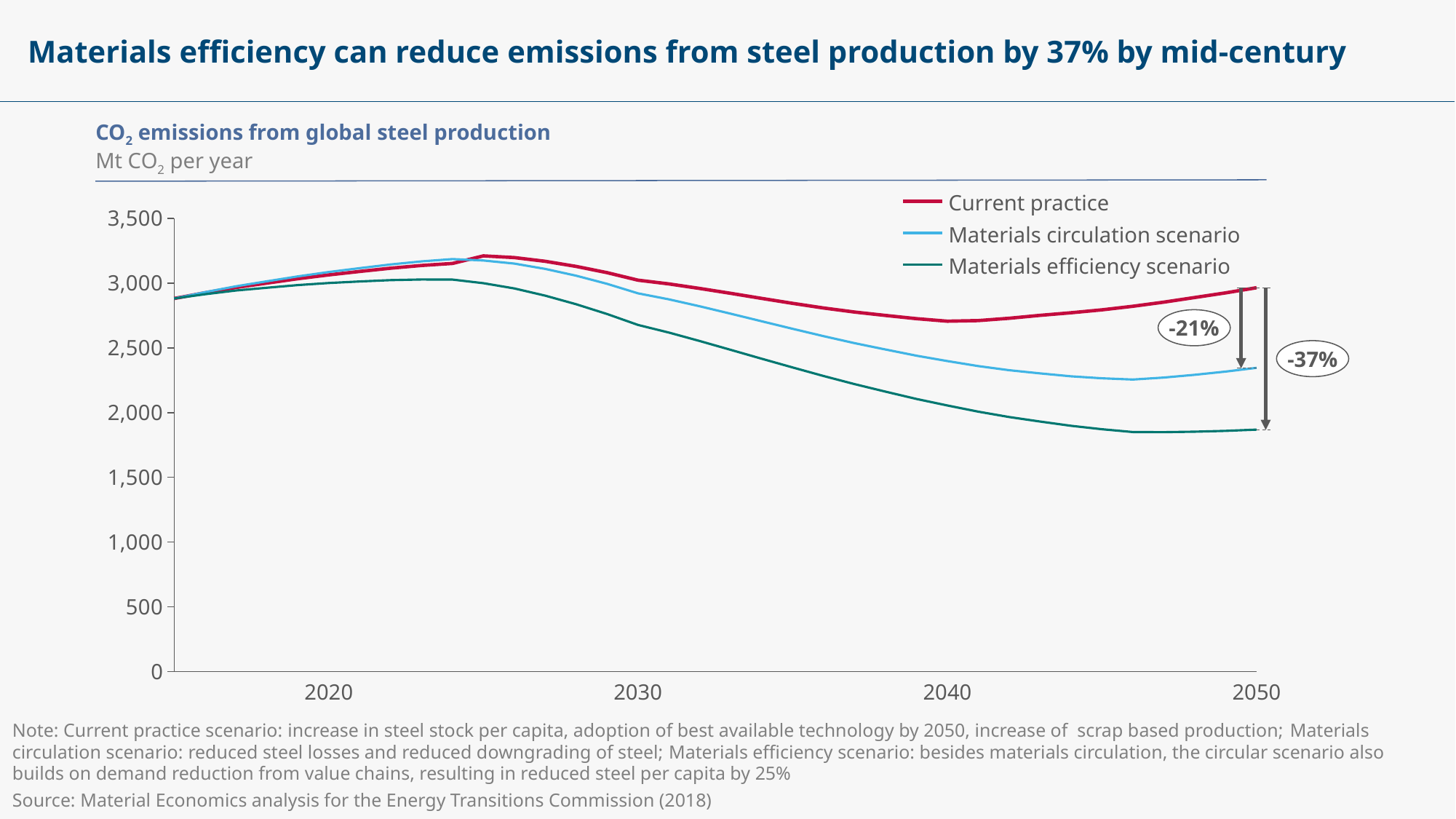
Does the Materials efficiency scenario line rise or fall between 2030 and 2040? Fall What percentage reduction is labelled for the Materials circulation scenario relative to Current practice in 2050? -21% Which series has the lowest value in 2050? Materials efficiency scenario What percentage reduction is labelled for the Materials efficiency scenario relative to Current practice in 2050? -37% Which series has the highest value in 2050? Current practice What unit is given for the y axis of the chart? Mt CO2 per year Which is larger in 2040, Current practice or the Materials efficiency scenario? Current practice How many series does the legend list? 3 What kind of chart is shown on the slide? Line chart Is the value for the Materials circulation scenario in 2050 greater or less than 2,000? greater Is the value for Current practice in 2050 greater or less than 2,500? greater Is the value for the Materials efficiency scenario in 2050 greater or less than 2,000? less